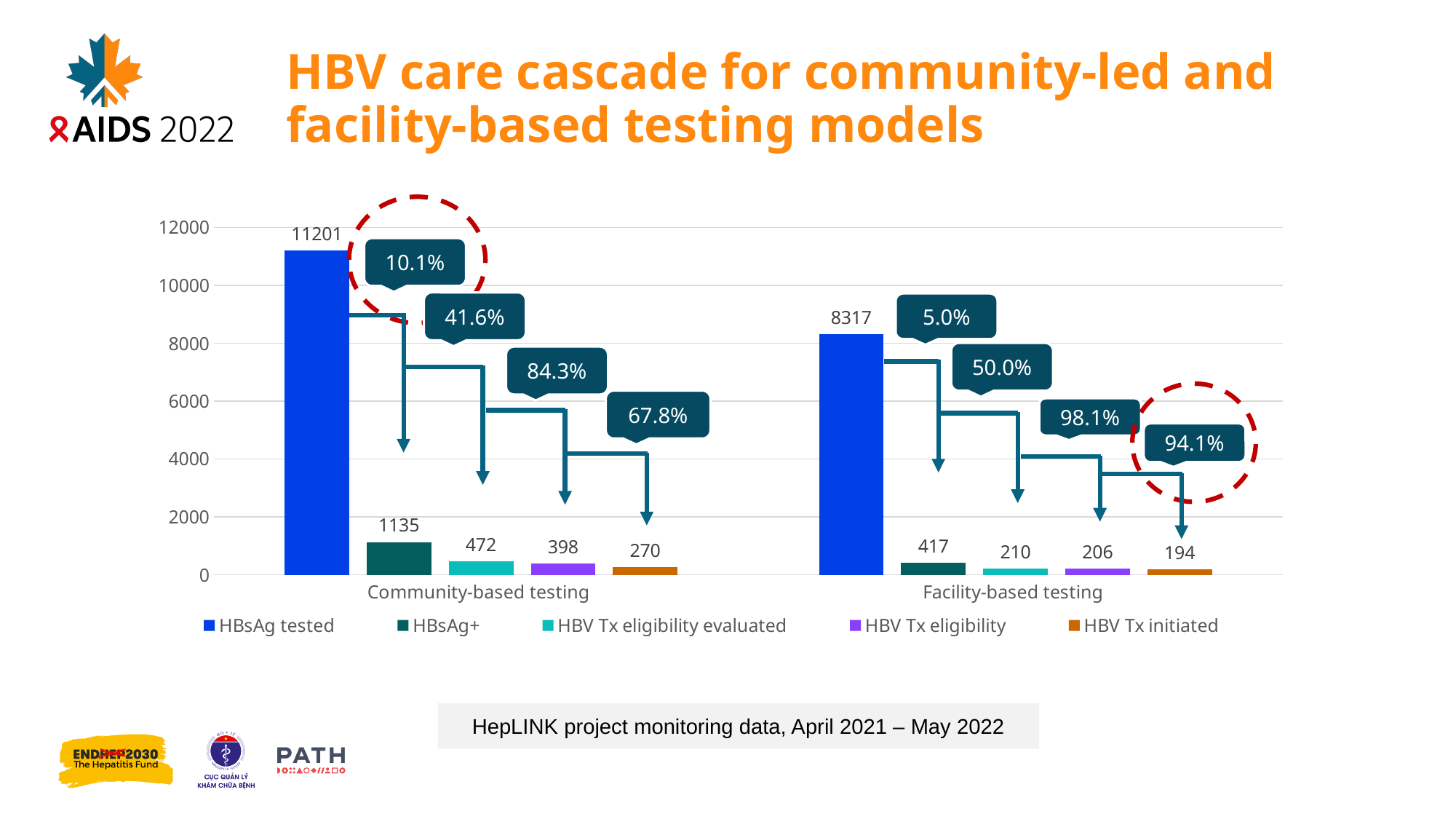
What is the difference between HBV Tx eligibility and HBV Tx initiated under Facility-based testing? 12 What is the difference between HBsAg tested for Community-based testing and Facility-based testing? 2884 What is the value for HBV Tx initiated under Community-based testing? 270 What kind of chart is shown on the slide? Bar chart Which series has the lowest value under Facility-based testing? HBV Tx initiated What is the value for HBsAg tested under Community-based testing? 11201 Which testing model has the higher value for HBV Tx initiated? Community-based testing What percentage is shown in the callout between HBV Tx eligibility and HBV Tx initiated for Facility-based testing? 94.1% How many series does the legend list? 5 What is the value for HBV Tx eligibility evaluated under Community-based testing? 472 What is the value for HBsAg+ under Facility-based testing? 417 What is the value for HBsAg tested under Facility-based testing? 8317